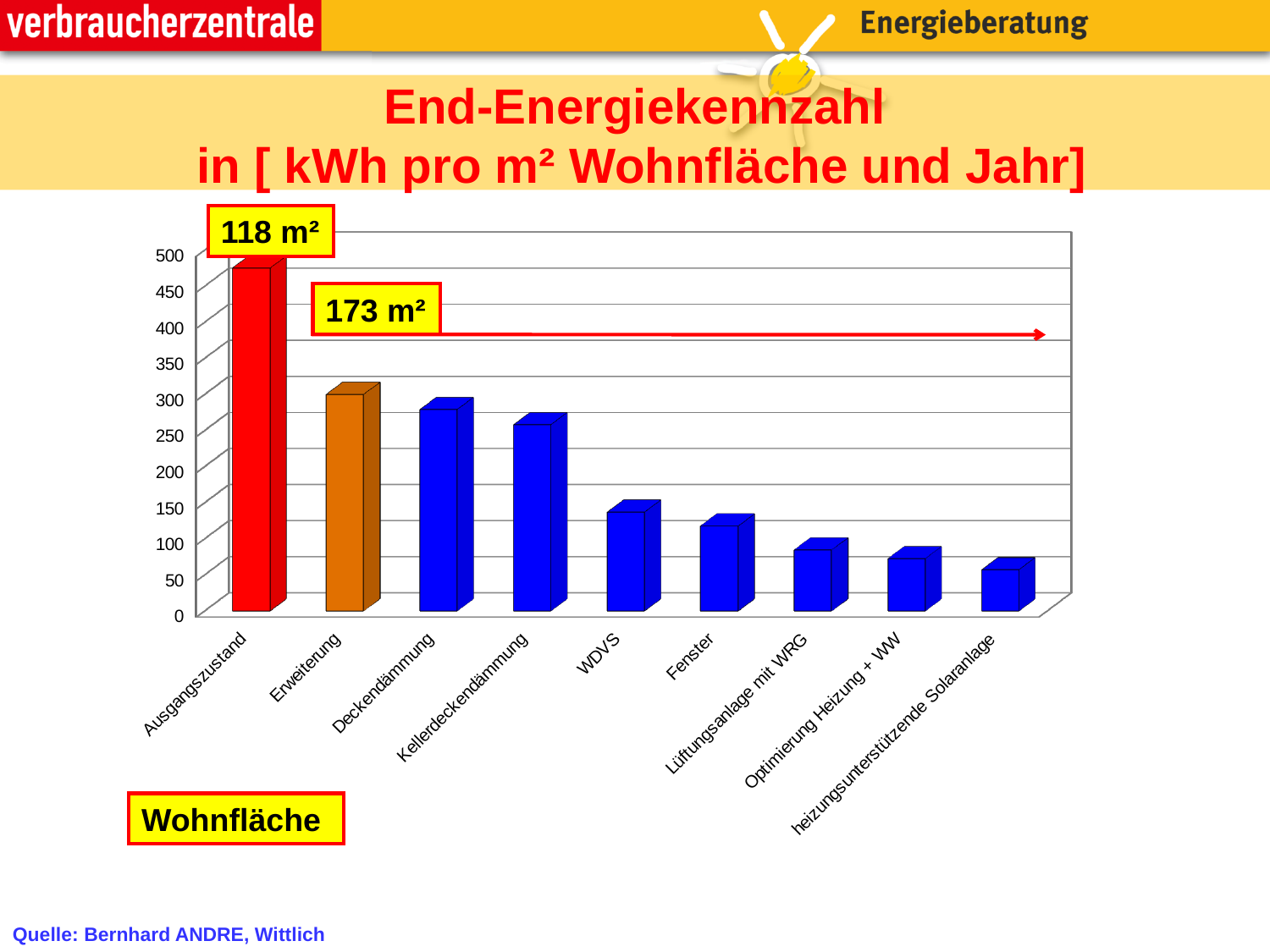
What colour is the bar for Ausgangszustand? red Is the value for WDVS greater or less than 200? less Do the values rise or fall from left to right along the x axis? fall Which has the larger value, Kellerdeckendämmung or Fenster? Kellerdeckendämmung Which category has the highest value in the chart? Ausgangszustand How many categories are shown on the x axis of the chart? 9 What kind of chart is shown on the slide? bar chart Which has the larger value, Ausgangszustand or Erweiterung? Ausgangszustand Is the value for Ausgangszustand greater or less than 400? greater Is the value for Lüftungsanlage mit WRG greater or less than 100? less Which category has the lowest value in the chart? heizungsunterstützende Solaranlage